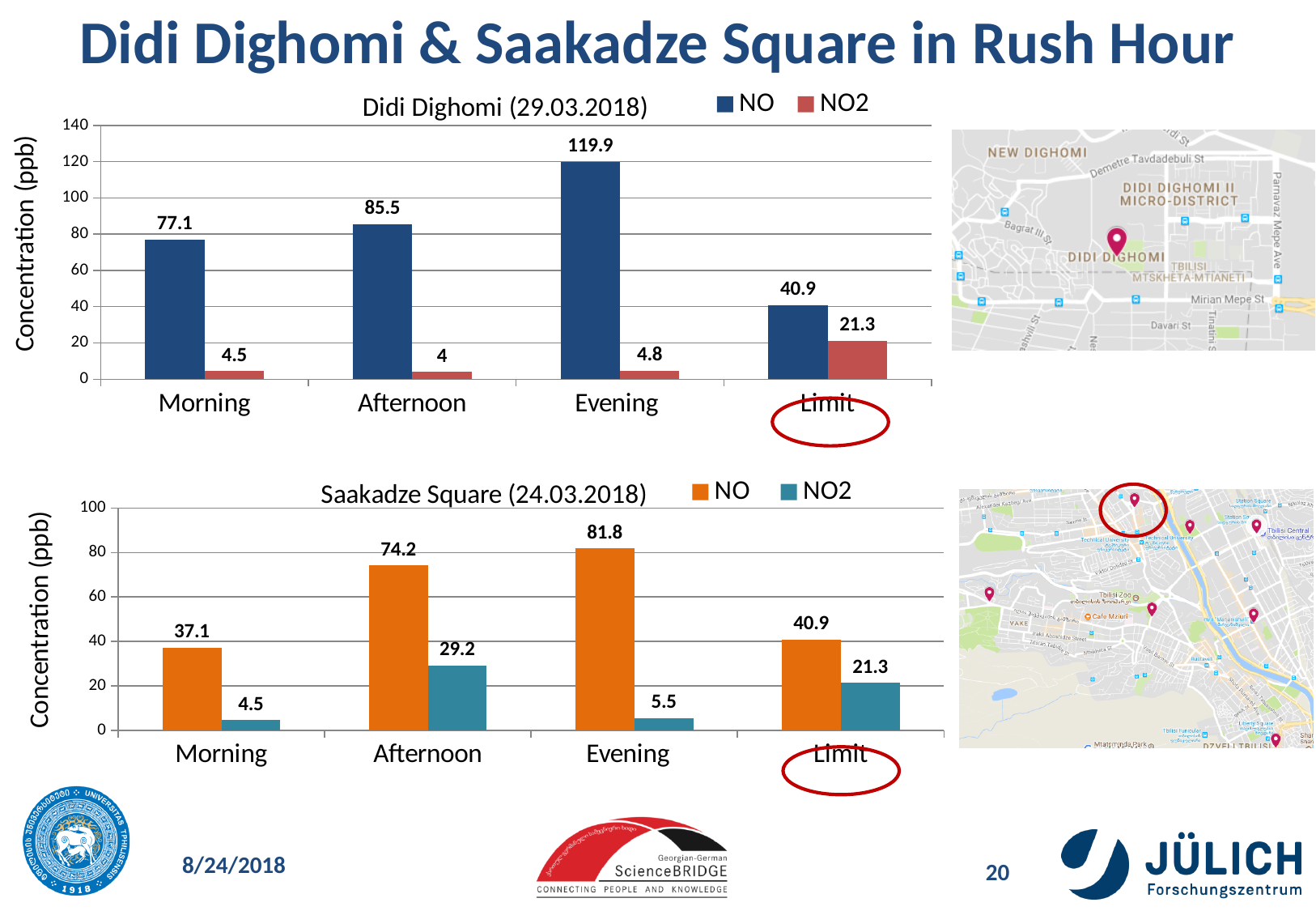
In the Didi Dighomi (29.03.2018) chart, which category has the highest NO value? Evening How many categories are shown on the x axis of the Didi Dighomi (29.03.2018) chart? 4 In the Didi Dighomi (29.03.2018) chart, what is the difference between the Evening NO value and the Limit NO value? 79 In the Saakadze Square (24.03.2018) chart, which is larger: the Evening NO value or the Afternoon NO value? Evening NO In the Didi Dighomi (29.03.2018) chart, is the Morning NO value greater or less than 80? less In the Saakadze Square (24.03.2018) chart, which category has the lowest NO value? Morning How many series does the legend of the Saakadze Square (24.03.2018) chart list? 2 What type of chart is the Saakadze Square (24.03.2018) chart? Bar chart In the Saakadze Square (24.03.2018) chart, what is the difference between the Afternoon NO2 value and the Limit NO2 value? 7.9 In the Didi Dighomi (29.03.2018) chart, what is the NO concentration in the Evening? 119.9 In the Didi Dighomi (29.03.2018) chart, what is the NO2 value for Afternoon? 4 In the Saakadze Square (24.03.2018) chart, what is the NO2 concentration in the Afternoon? 29.2